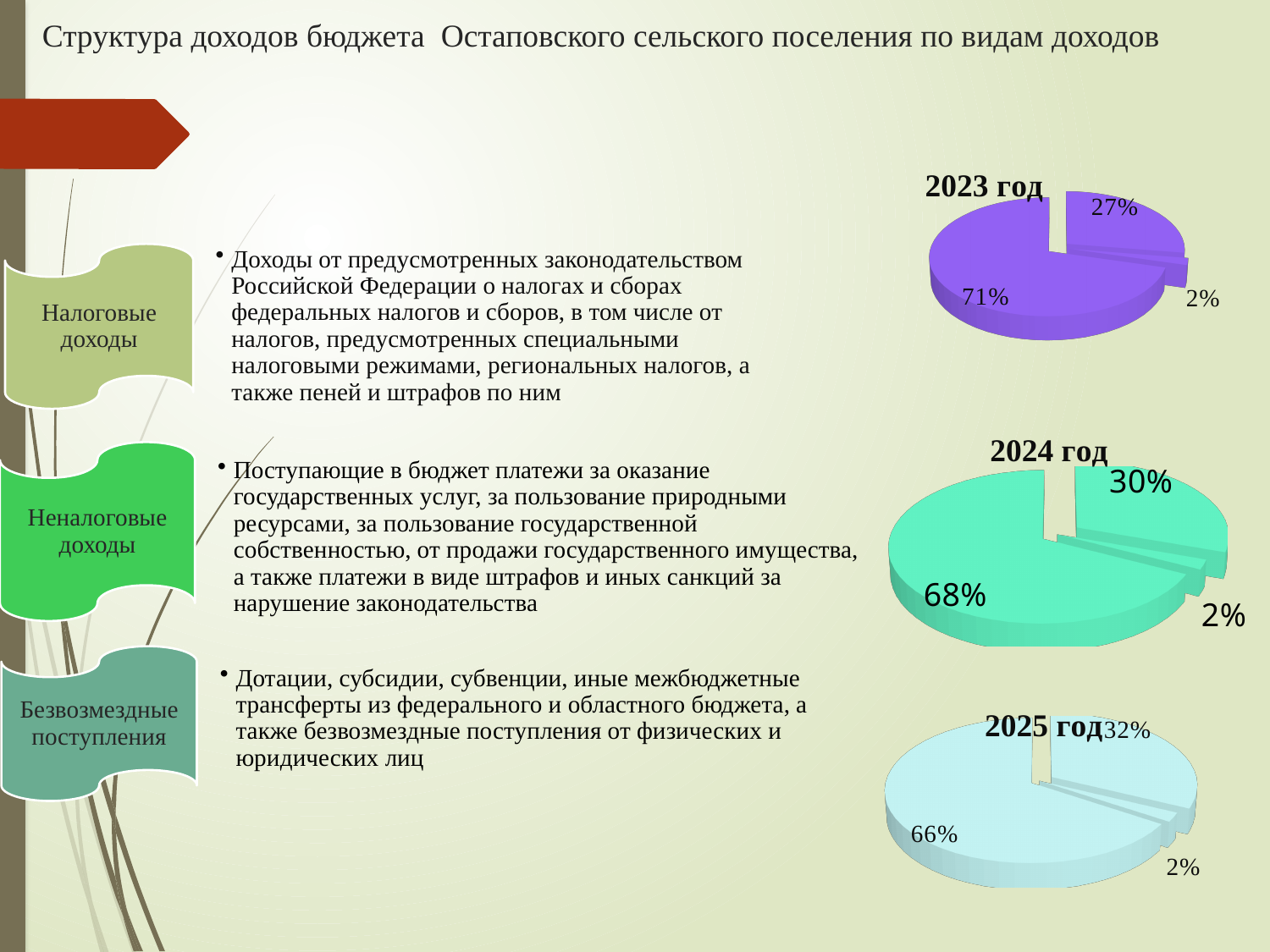
In the "2025 год" pie chart, what is the share of the second-largest slice? 32% How many slices does the "2024 год" pie chart have? 3 Which is larger: the largest slice in the "2023 год" chart or the largest slice in the "2025 год" chart? 2023 год (71%) Across the three pie charts, does the share of the largest slice rise or fall from 2023 to 2025? fall In the "2023 год" pie chart, what is the share of the largest slice? 71% In the "2024 год" pie chart, what is the difference between the two largest slices (68% and 30%)? 38% In the "2025 год" pie chart, what is the share of the largest slice? 66% In the "2024 год" pie chart, what is the share of the largest slice? 68% In the "2023 год" pie chart, what is the share of the smallest slice? 2% What kind of chart is the "2023 год" chart? pie chart What colour are the slices of the "2023 год" pie chart? purple How many pie charts are shown on the slide? 3